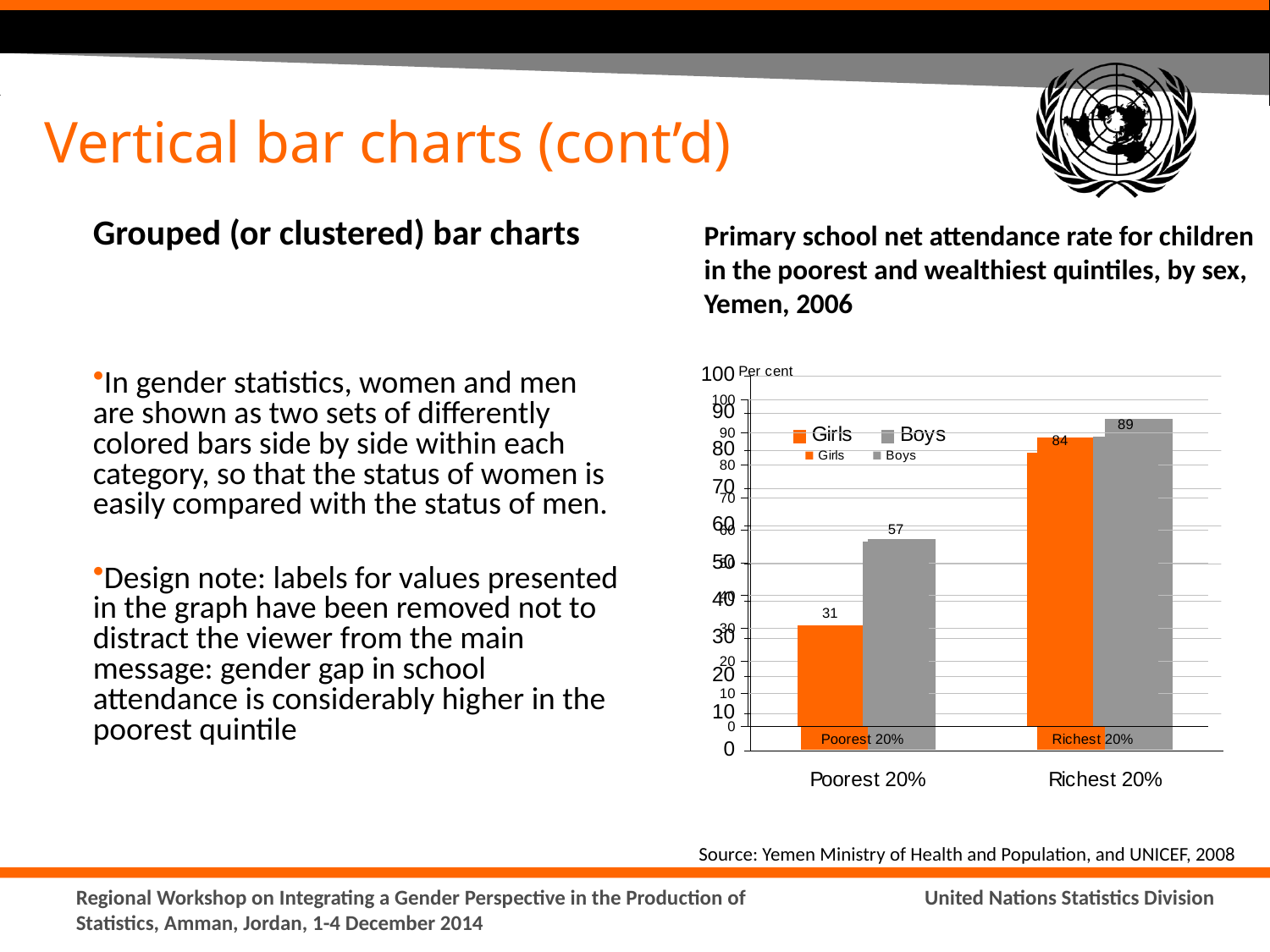
What kind of chart is shown on the slide? Bar chart Which bar has the highest value in the chart? Boys, Richest 20% What is the value for Girls in the Richest 20% category? 84 What is the difference between Boys and Girls in the Richest 20% category? 5 What unit is shown on the vertical axis of the chart? Per cent Which bar has the lowest value in the chart? Girls, Poorest 20% What is the value for Girls in the Poorest 20% category? 31 What is the value for Boys in the Richest 20% category? 89 How many series does the legend list? 2 Which is larger: Girls in the Richest 20% or Boys in the Poorest 20%? Girls in the Richest 20% What is the difference between Boys and Girls in the Poorest 20% category? 26 What is the value for Boys in the Poorest 20% category? 57